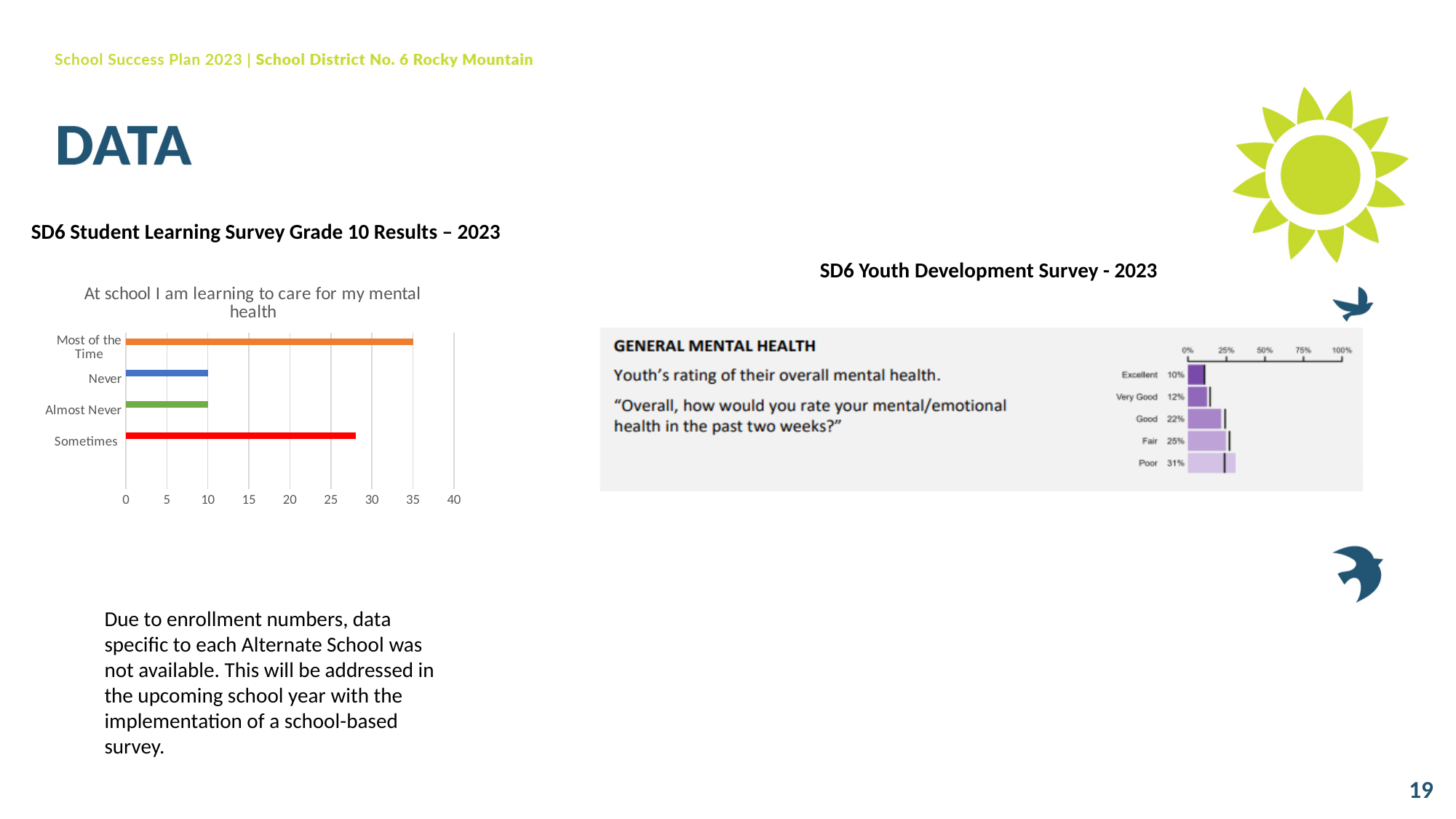
In the chart titled 'At school I am learning to care for my mental health', which is larger, Sometimes or Almost Never? Sometimes In the General Mental Health chart on the right, which rating has the highest percentage? Poor In the General Mental Health chart on the right, what is the difference between the Fair and Very Good percentages? 13% In the chart titled 'At school I am learning to care for my mental health', how many categories are shown? 4 In the chart titled 'At school I am learning to care for my mental health', what value does the Never bar reach? 10 In the chart titled 'At school I am learning to care for my mental health', is the value for Most of the Time greater or less than 30? greater In the General Mental Health chart on the right, what percentage of youth rated their mental health as Excellent? 10% What kind of chart is the one titled 'At school I am learning to care for my mental health'? bar chart In the chart titled 'At school I am learning to care for my mental health', which category has the longest bar? Most of the Time In the chart titled 'At school I am learning to care for my mental health', is the value for Sometimes greater or less than 25? greater In the General Mental Health chart on the right, what percentage of youth rated their mental health as Poor? 31% In the General Mental Health chart on the right, how many rating categories are listed? 5